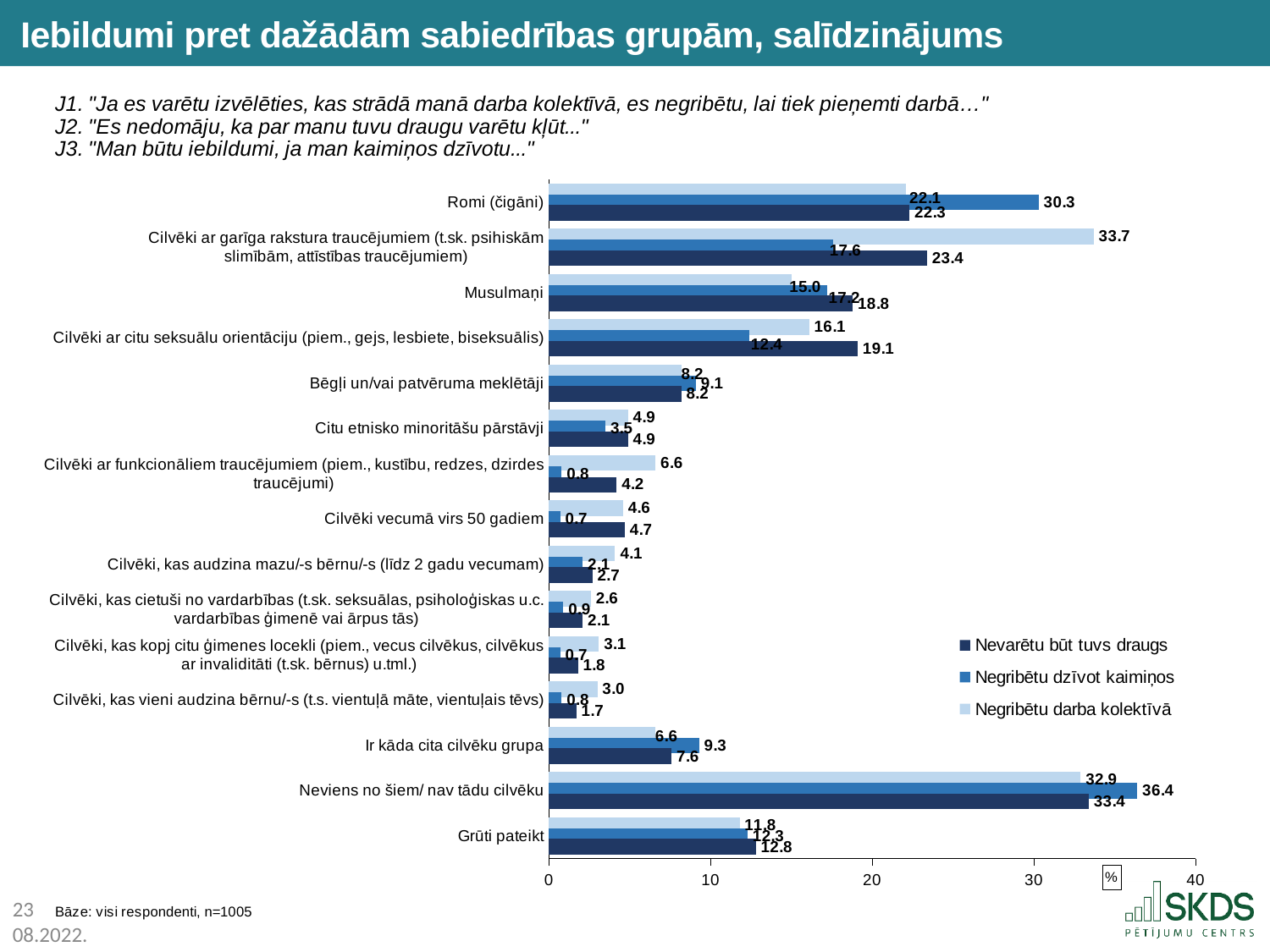
How many categories are shown on the chart? 15 What kind of chart is shown on the slide? bar chart How many series does the legend list? 3 What is the value of "Negribētu darba kolektīvā" for Cilvēki ar garīga rakstura traucējumiem? 33.7 Is the value of "Negribētu darba kolektīvā" for Neviens no šiem/ nav tādu cilvēku greater or less than 30? greater For Musulmaņi, what is the difference between "Nevarētu būt tuvs draugs" (18.8) and "Negribētu darba kolektīvā" (15.0)? 3.8 Which category has the highest value for "Negribētu dzīvot kaimiņos"? Neviens no šiem/ nav tādu cilvēku What is the value of "Negribētu dzīvot kaimiņos" for Ir kāda cita cilvēku grupa? 9.3 For Cilvēki ar garīga rakstura traucējumiem, what is the difference between "Negribētu darba kolektīvā" and "Nevarētu būt tuvs draugs"? 10.3 What is the value of "Negribētu dzīvot kaimiņos" for Romi (čigāni)? 30.3 For Cilvēki ar citu seksuālu orientāciju, which series has the larger value: "Nevarētu būt tuvs draugs" or "Negribētu dzīvot kaimiņos"? Nevarētu būt tuvs draugs What is the value of "Negribētu darba kolektīvā" for Grūti pateikt? 11.8